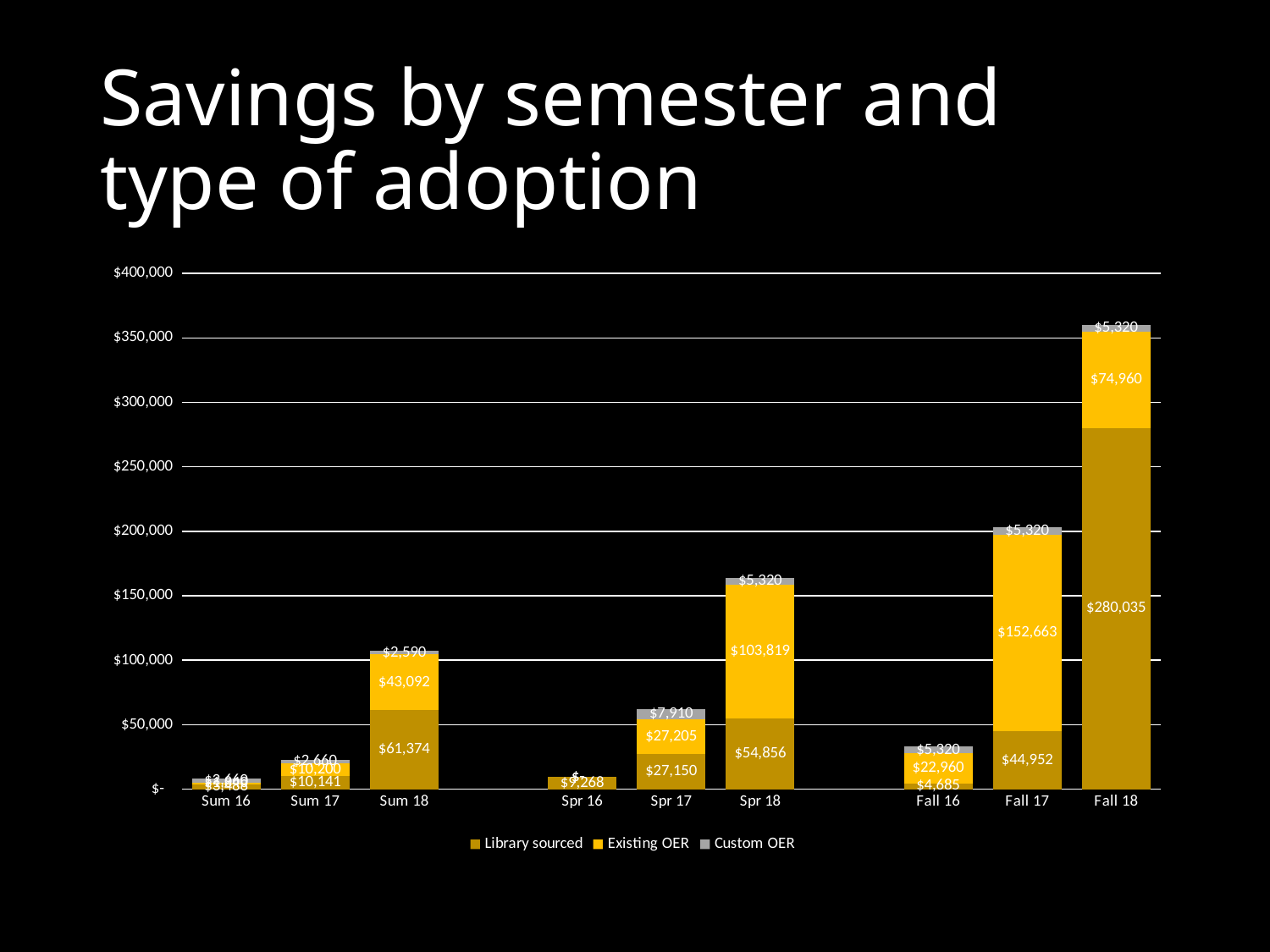
Which semester has the lowest total savings? Sum 16 What is the Library sourced savings value for Fall 18? $280,035 What type of chart is shown on the slide? Stacked bar chart What is the difference between the Library sourced savings in Fall 18 and in Fall 17? $235,083 What is the Custom OER savings value for Spr 17? $7,910 In Spr 18, which is larger: Existing OER savings or Library sourced savings? Existing OER Is the total savings for Spr 18 greater or less than $150,000? greater Which semester has the highest total savings? Fall 18 What is the Existing OER savings value for Fall 17? $152,663 How many series does the legend list? 3 What is the total savings for Fall 18 across all three types of adoption? $360,315 How many semesters are shown on the x axis? 9